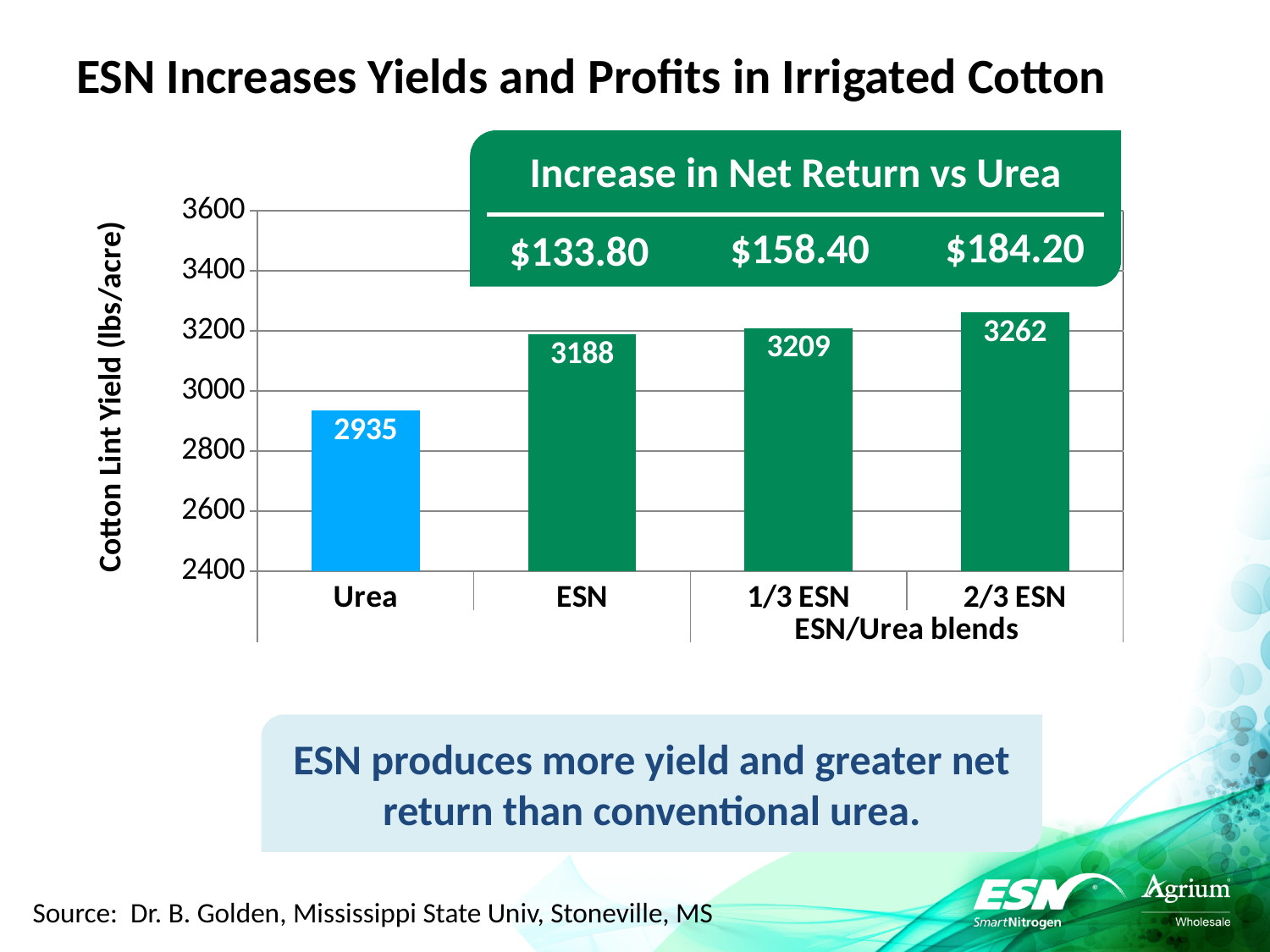
Is the cotton lint yield for Urea greater or less than 3000? less Which treatment has the highest cotton lint yield? 2/3 ESN What is the cotton lint yield for ESN? 3188 What is the cotton lint yield for Urea? 2935 Which has a higher cotton lint yield, Urea or 1/3 ESN? 1/3 ESN Which treatment has the lowest cotton lint yield? Urea What is the increase in net return vs urea shown for the 2/3 ESN blend? $184.20 What is the cotton lint yield for the 2/3 ESN blend? 3262 What kind of chart is shown on the slide? bar chart What is the difference in cotton lint yield between 2/3 ESN and Urea? 327 What is the difference in cotton lint yield between 1/3 ESN and ESN? 21 How many treatments are shown on the chart? 4